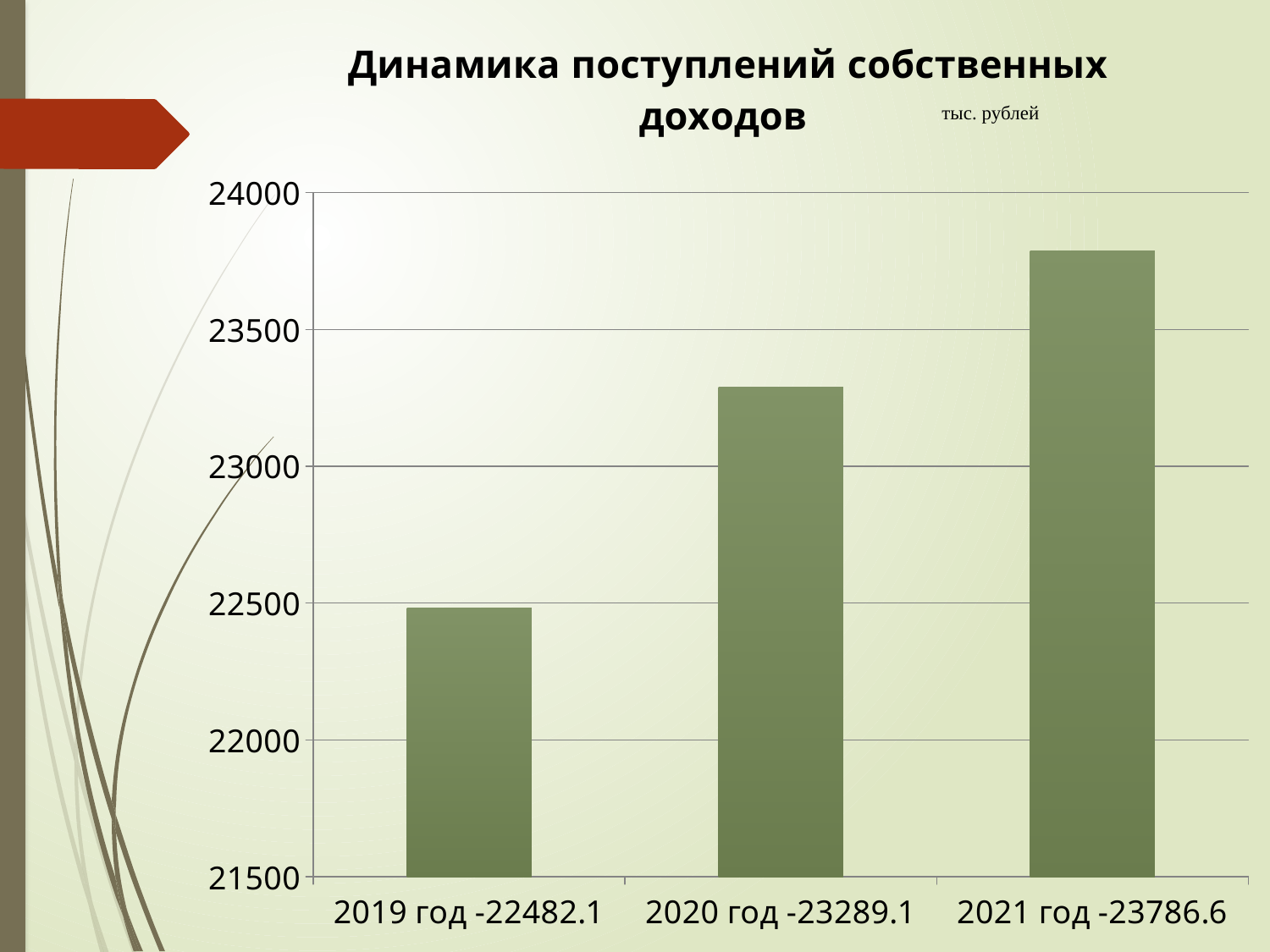
What is the value for 2019 год? 22482.1 What type of chart is shown on the slide? Bar chart Do the values rise or fall from 2019 to 2021? Rise What is the value for 2020 год? 23289.1 Which year has the lowest value? 2019 год Which year has the highest value? 2021 год What is the value for 2021 год? 23786.6 What is the title of the chart? Динамика поступлений собственных доходов In what units are the values on the chart expressed, according to the slide? тыс. рублей What is the difference between the values for 2020 год and 2019 год? 807.0 What is the difference between the values for 2021 год and 2020 год? 497.5 How many bars (years) are shown on the chart? 3